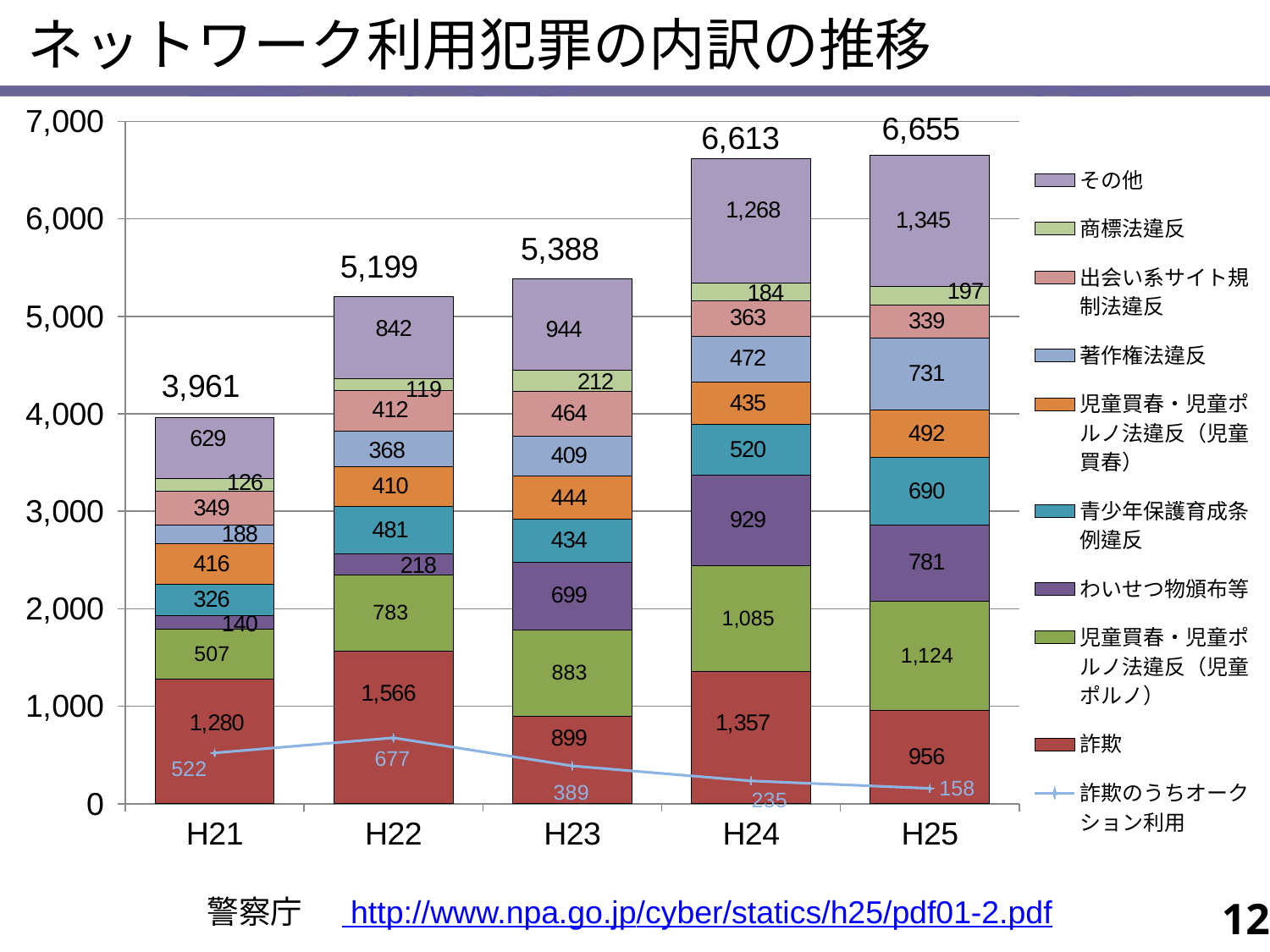
What kind of chart is this? Stacked bar chart with a line Does the 詐欺のうちオークション利用 line rise or fall from H22 to H25? Fall How many years are shown on the x axis? 5 What is the total for H24? 6,613 Which is larger, the 詐欺 value for H24 or for H25? H24 What is the value of 詐欺のうちオークション利用 for H23? 389 What is the value of 詐欺 for H22? 1,566 What is the value of その他 for H25? 1,345 Which year has the lowest total? H21 What is the difference between the totals for H25 and H21? 2,694 Which year has the highest total? H25 How many series does the legend list? 10